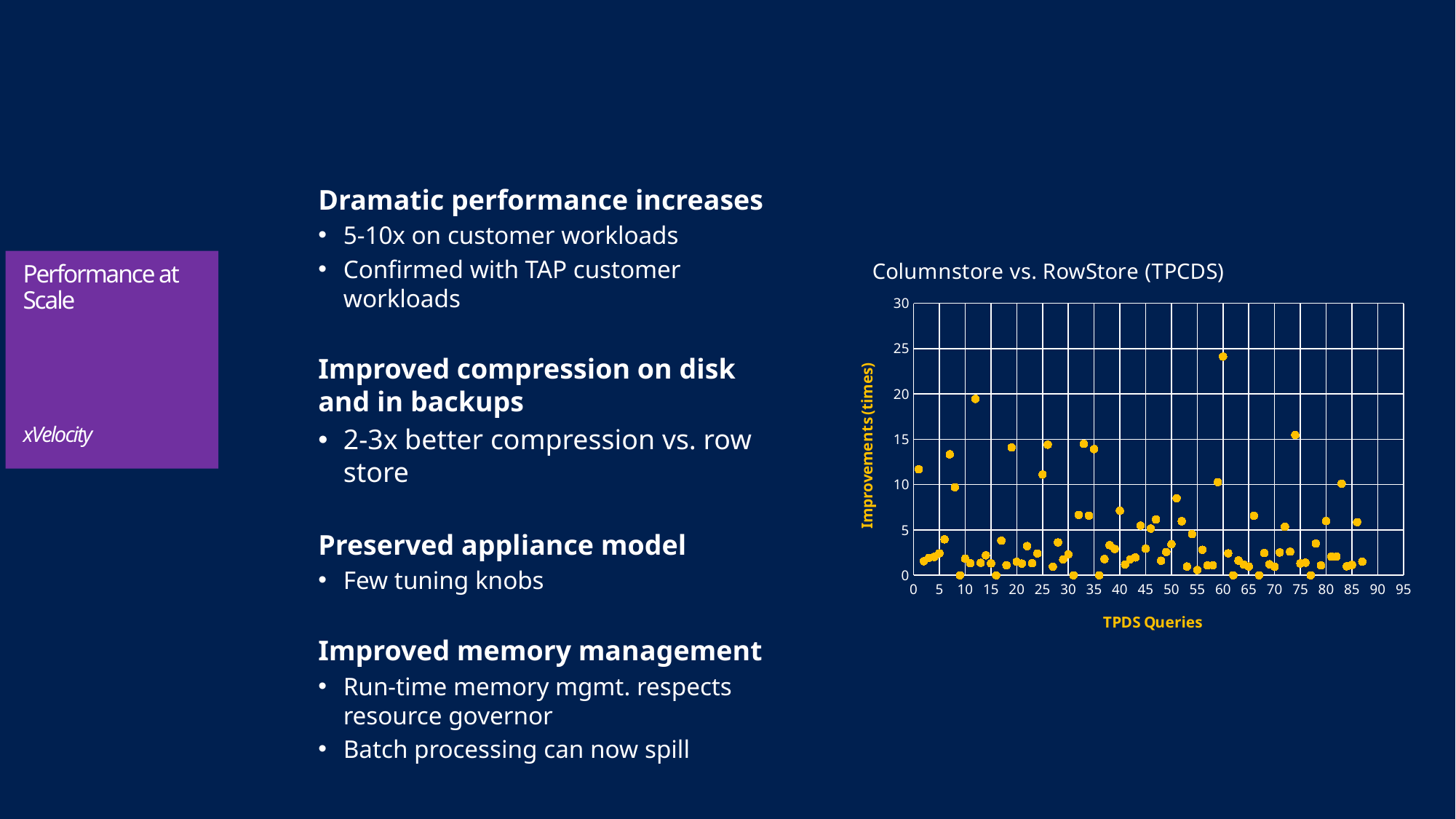
Is the highest plotted improvement value greater or less than 25? less What is the highest value shown on the vertical axis of the chart? 30 Is the improvement value for the point near x = 12 greater or less than 15? greater What is the highest value shown on the horizontal axis of the chart? 95 What is the label on the vertical axis of the chart? Improvements (times) What kind of chart is shown on the slide? Scatter chart Near which horizontal-axis tick does the highest plotted point appear? 60 Is the improvement value for the point near x = 90 greater or less than 5? less What is the title of the chart? Columnstore vs. RowStore (TPCDS)